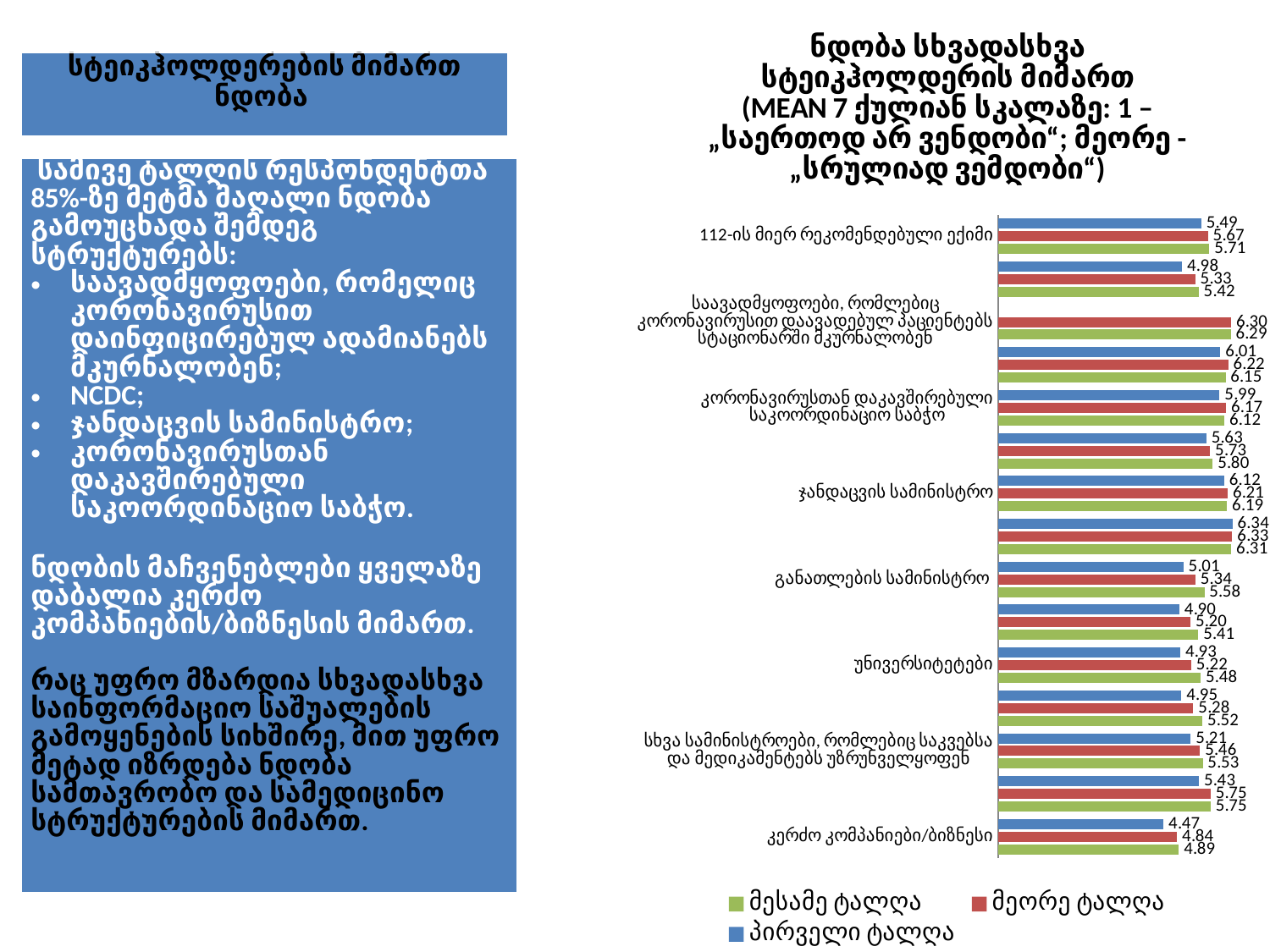
What kind of chart is shown on the slide? Bar chart What is the difference between the მეორე ტალღა and პირველი ტალღა values for ჯანდაცვის სამინისტრო? 0.09 How many series does the legend list? 3 What is the value for მესამე ტალღა for the category კერძო კომპანიები/ბიზნესი? 4.89 What is the difference between the მესამე ტალღა and პირველი ტალღა values for კერძო კომპანიები/ბიზნესი? 0.42 What is the value for პირველი ტალღა for the category 112-ის მიერ რეკომენდებული ექიმი? 5.49 Which series is shown in blue in the legend? პირველი ტალღა What is the value for მეორე ტალღა for the category ჯანდაცვის სამინისტრო? 6.21 What is the value for პირველი ტალღა for the category განათლების სამინისტრო? 5.01 Which labeled category has the lowest value for პირველი ტალღა? კერძო კომპანიები/ბიზნესი Which is larger for მეორე ტალღა: ჯანდაცვის სამინისტრო or კერძო კომპანიები/ბიზნესი? ჯანდაცვის სამინისტრო Which is larger for მესამე ტალღა: უნივერსიტეტები or განათლების სამინისტრო? განათლების სამინისტრო